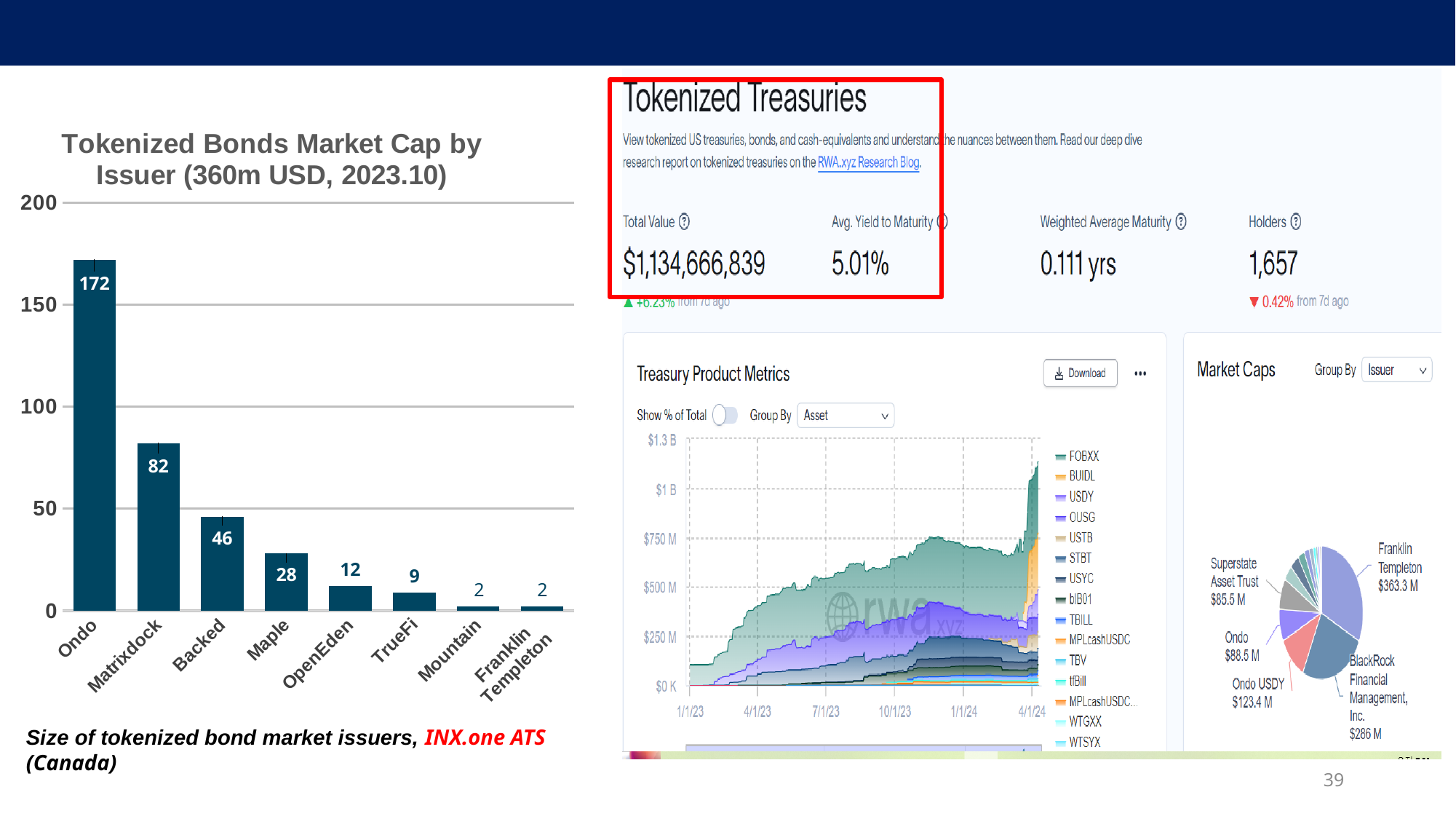
In the 'Tokenized Bonds Market Cap by Issuer' bar chart, what is the value for Matrixdock? 82 In the 'Tokenized Bonds Market Cap by Issuer' bar chart, which is larger, the value for Backed or the value for OpenEden? Backed In the 'Tokenized Bonds Market Cap by Issuer' bar chart, what is the value for Maple? 28 In the 'Tokenized Bonds Market Cap by Issuer' bar chart, which issuer has the highest market cap? Ondo In the 'Market Caps' pie chart on the right of the slide, what is the market cap shown for BlackRock Financial Management, Inc.? $286 M What kind of chart is the 'Tokenized Bonds Market Cap by Issuer' chart? bar chart In the 'Tokenized Bonds Market Cap by Issuer' bar chart, what is the difference between the values for Ondo and Matrixdock? 90 In the 'Tokenized Bonds Market Cap by Issuer' bar chart, what is the value for Ondo? 172 In the 'Market Caps' pie chart on the right of the slide, what is the market cap shown for Franklin Templeton? $363.3 M In the 'Tokenized Bonds Market Cap by Issuer' bar chart, do the values rise or fall from left to right? fall How many issuers are shown in the 'Tokenized Bonds Market Cap by Issuer' bar chart? 8 In the 'Tokenized Bonds Market Cap by Issuer' bar chart, is the value for Matrixdock greater or less than 100? less